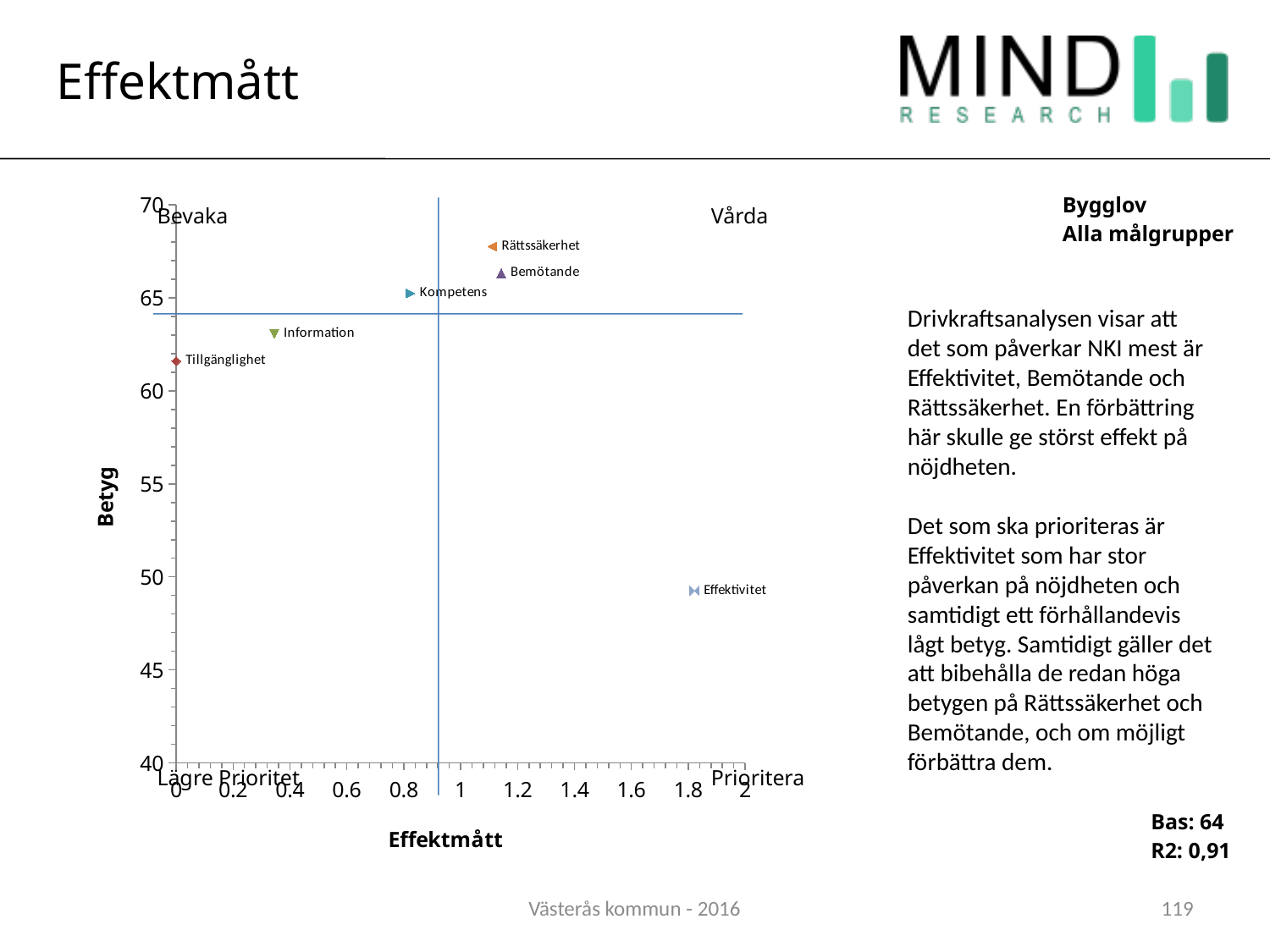
Which data point has the lowest Effektmått value? Tillgänglighet Which data point has the lowest Betyg value? Effektivitet Is the Betyg value for Tillgänglighet greater or less than 60? greater Is the Effektmått value for Effektivitet greater or less than 1.6? greater Is the Betyg value for Effektivitet greater or less than 55? less Which data point has the highest Betyg value? Rättssäkerhet How many labelled data points are plotted in the chart? 6 Which data point has the highest Effektmått value? Effektivitet What kind of chart is shown on the slide? scatter chart What is the title of the horizontal axis of the chart? Effektmått Which has a higher Betyg value, Kompetens or Information? Kompetens